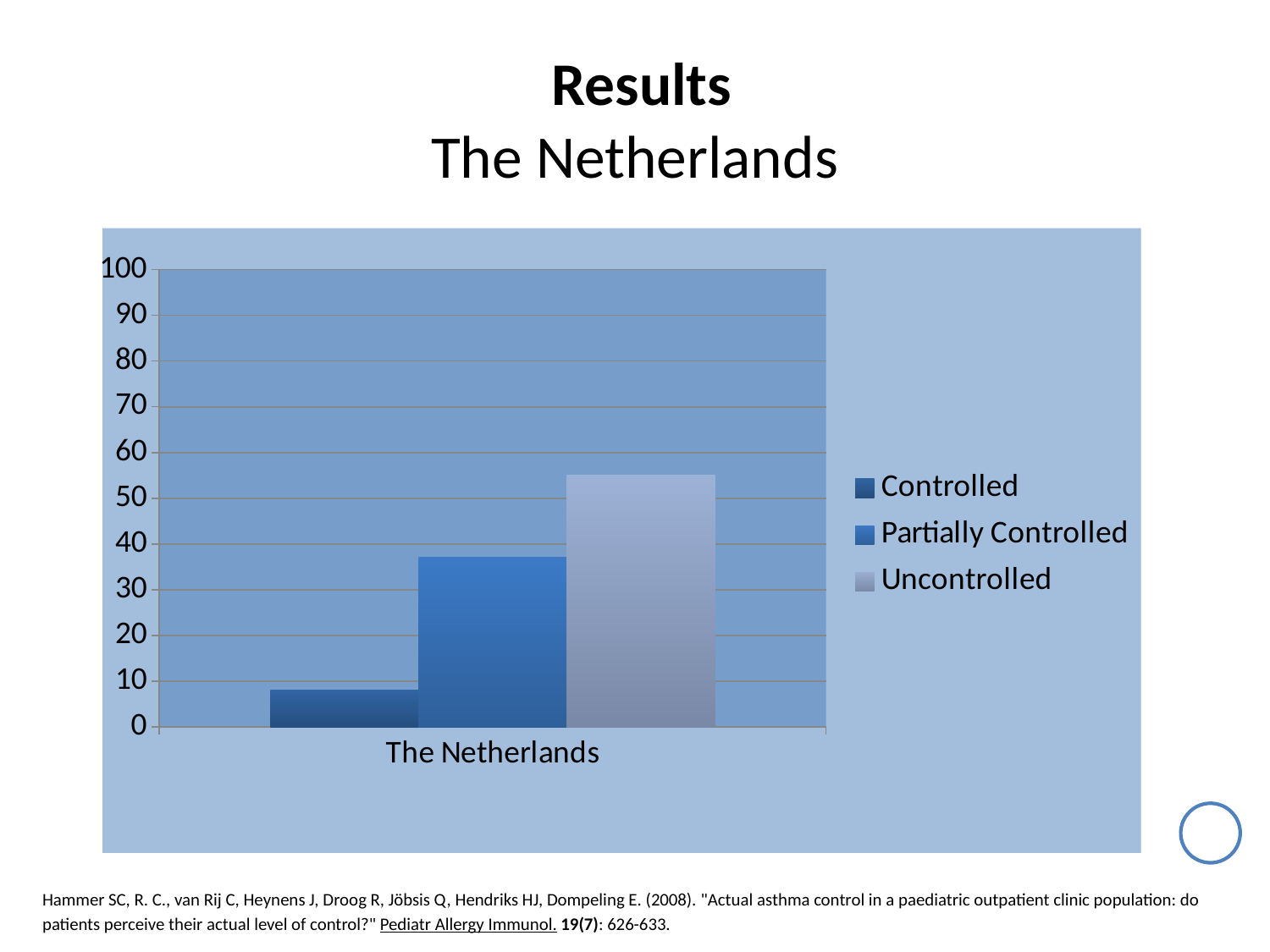
Is the value for Partially Controlled greater or less than 40? less How many categories are shown on the x axis? 1 Which is larger for The Netherlands, Partially Controlled or Uncontrolled? Uncontrolled Is the value for Controlled greater or less than 10? less What is the highest value shown on the y axis? 100 How many series does the legend list? 3 Which series has the highest value for The Netherlands? Uncontrolled What is the category label shown on the x axis? The Netherlands Which is larger for The Netherlands, Controlled or Partially Controlled? Partially Controlled Is the value for Uncontrolled greater or less than 50? greater Which series has the lowest value for The Netherlands? Controlled What kind of chart is shown on the slide? bar chart